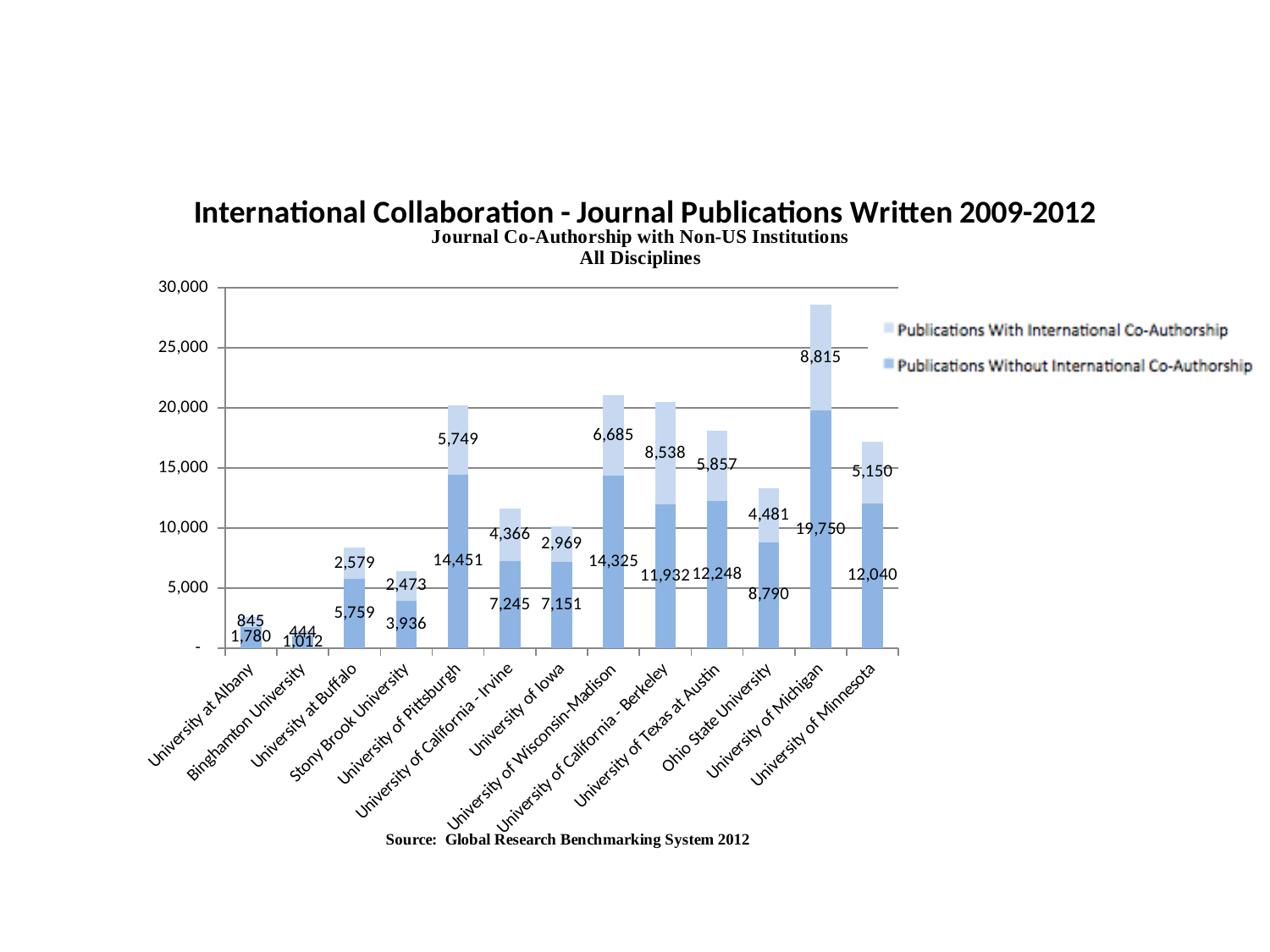
What source is cited below the chart? Global Research Benchmarking System 2012 Which university has the lowest number of Publications Without International Co-Authorship? Binghamton University Is the total stacked bar for the University of Michigan greater or less than 25,000? greater What is the value of Publications With International Co-Authorship for the University of California - Berkeley? 8,538 What kind of chart is shown on the slide? Stacked bar chart Which university has the highest number of Publications With International Co-Authorship? University of Michigan What is the difference between the Publications Without International Co-Authorship values for the University of Pittsburgh and the University of Wisconsin-Madison? 126 How many universities are shown on the x axis? 13 What is the value of Publications Without International Co-Authorship for the University of Michigan? 19,750 How many series does the legend list? 2 What is the total height of the stacked bar for the University of Michigan? 28,565 Which has more Publications With International Co-Authorship: the University of California - Berkeley or the University of Texas at Austin? University of California - Berkeley